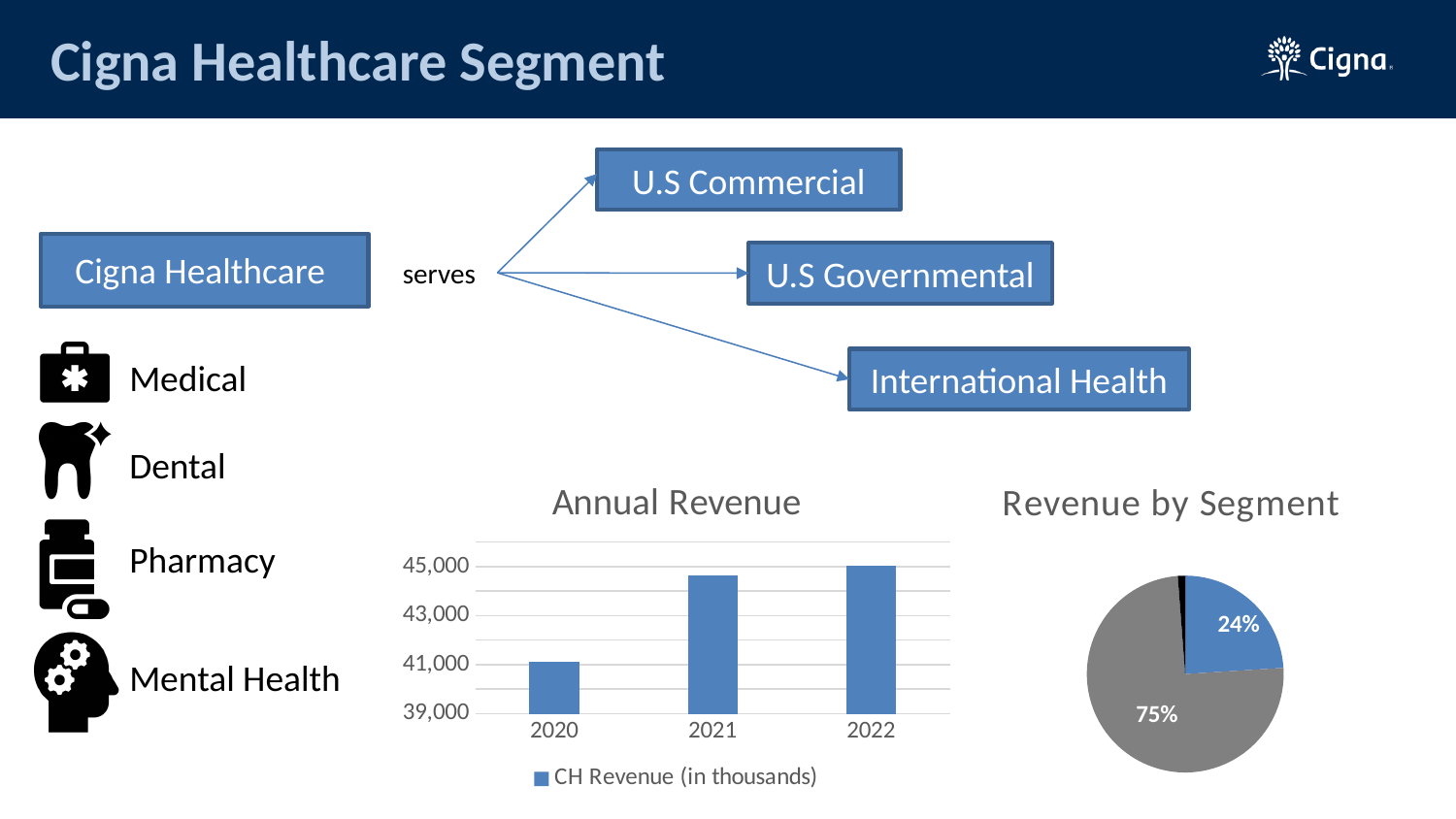
In the Revenue by Segment chart, what share does the largest slice have? 75% In the Annual Revenue chart, do the values rise or fall from 2020 to 2022? rise In the Annual Revenue chart, is the value for 2021 greater or less than 43,000? greater How many series does the legend of the Annual Revenue chart list? 1 How many years are shown on the x axis of the Annual Revenue chart? 3 In the Annual Revenue chart, which year has the lowest revenue? 2020 In the Annual Revenue chart, is the value for 2020 greater or less than 43,000? less What kind of chart is the Annual Revenue chart? bar chart What is the legend entry of the Annual Revenue chart? CH Revenue (in thousands) In the Revenue by Segment chart, what is the difference in percentage points between the 75% slice and the 24% slice? 51 percentage points What kind of chart is the Revenue by Segment chart? pie chart In the Annual Revenue chart, which year has the highest revenue? 2022